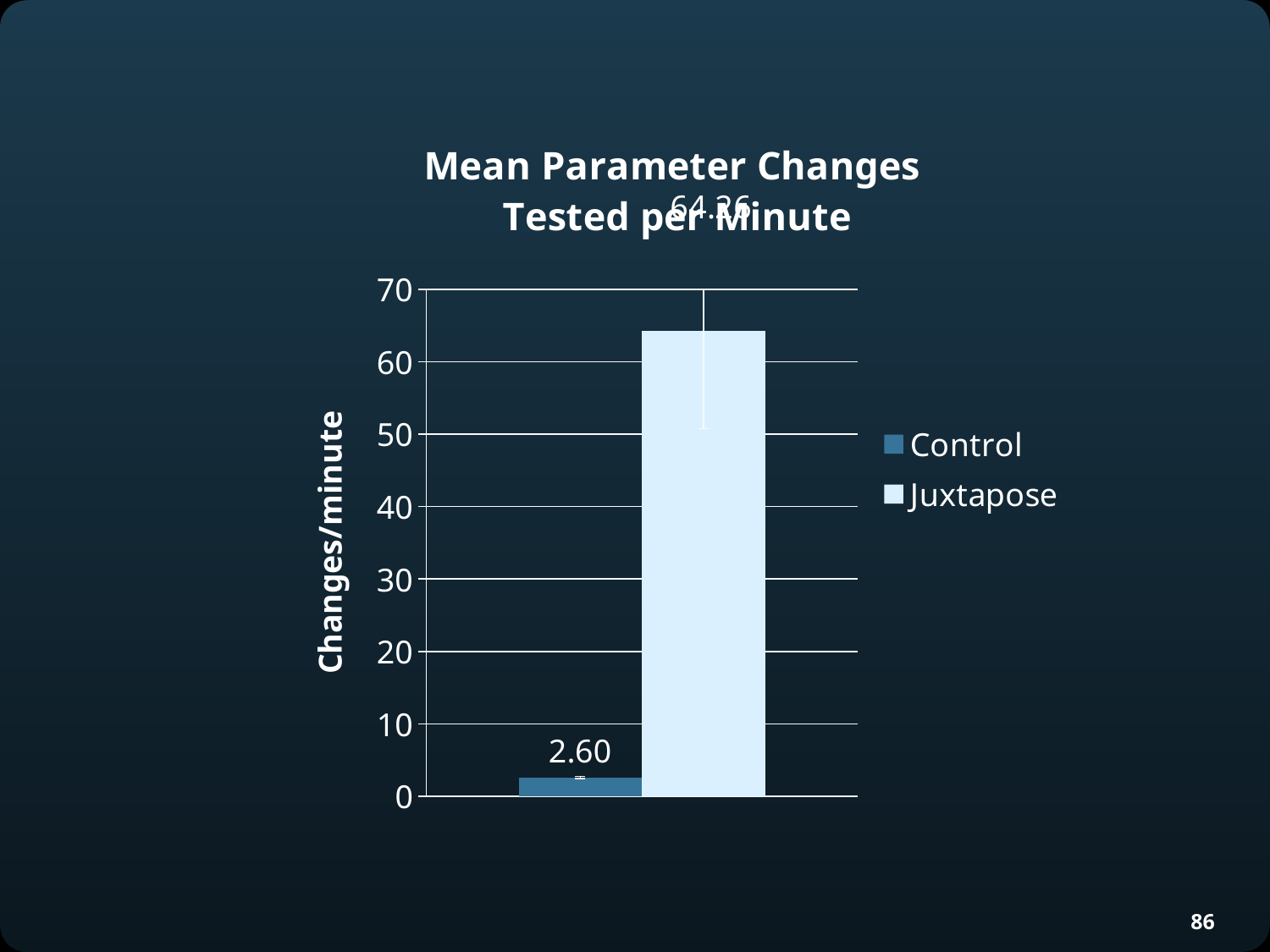
What is the label on the vertical axis of the chart? Changes/minute Is the value for Control greater or less than 10? less Which series has the highest value in the chart? Juxtapose Is the value for Juxtapose greater or less than 70? less What is the value for Control in the chart? 2.60 How many series does the legend list? 2 Which series has the lowest value in the chart? Control How many bars are plotted in the chart? 2 What kind of chart is shown on the slide? bar chart What is the title of the chart? Mean Parameter Changes Tested per Minute Is the value for Juxtapose greater or less than 60? greater Which is larger, the value for Control or the value for Juxtapose? Juxtapose